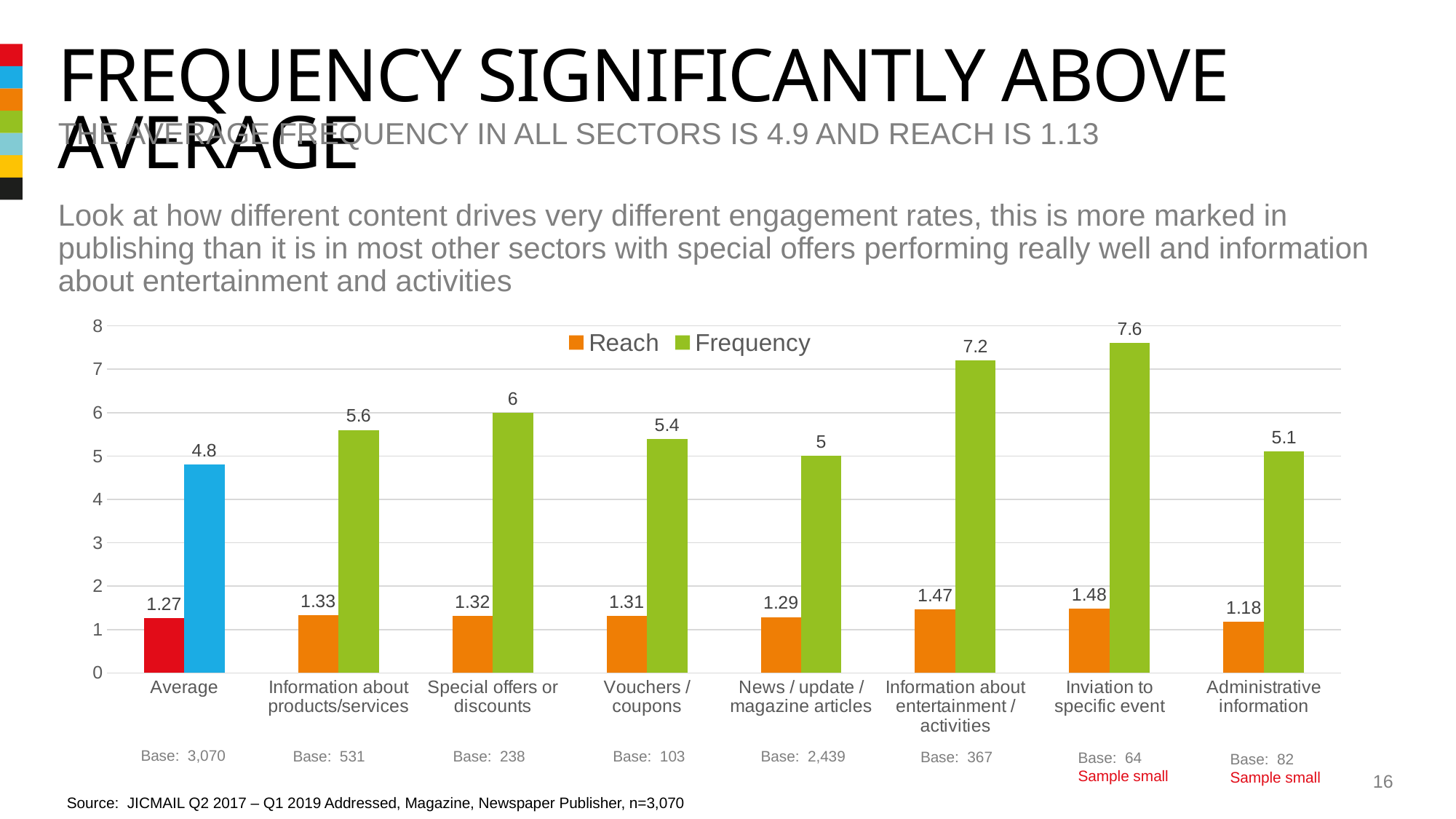
Which category has the lowest Reach value? Administrative information What colour are the Frequency bars in the legend? Green What is the difference between the Frequency values for Special offers or discounts and Vouchers / coupons? 0.6 Is the Frequency value for Information about entertainment / activities greater or less than 7? greater What is the Reach value for Information about entertainment / activities? 1.47 Which category has the highest Frequency value? Invitation to specific event How many categories are shown on the x axis? 8 How many series does the legend list? 2 What is the Frequency value for Invitation to specific event? 7.6 What is the Frequency value for Average? 4.8 Which has a higher Reach value, Information about products/services or News / update / magazine articles? Information about products/services What kind of chart is shown on the slide? Bar chart